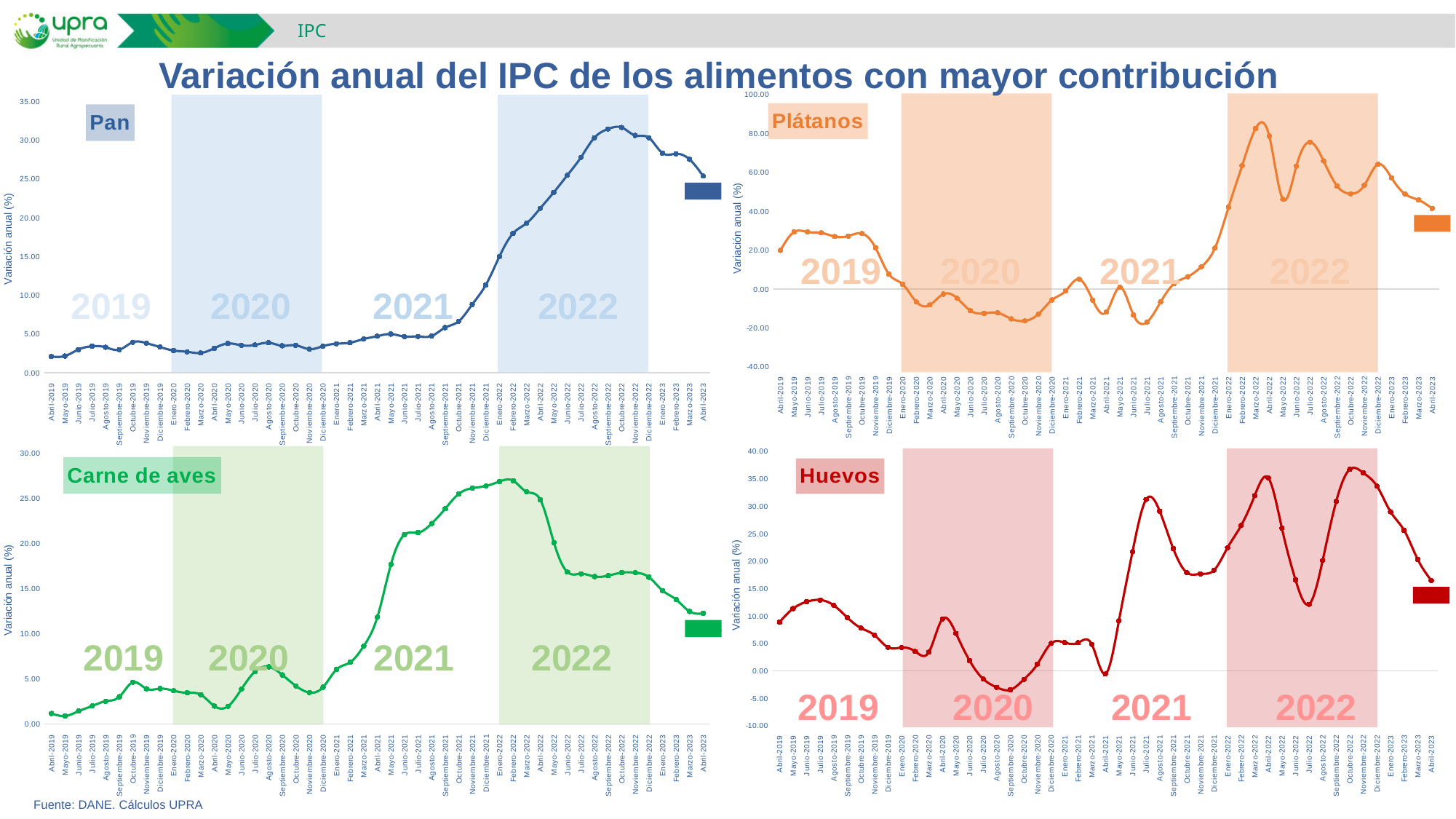
In the 'Carne de aves' chart, is the value for Febrero-2022 greater or less than 25? greater In the 'Pan' chart, is the value for Octubre-2022 greater or less than 30? greater In the 'Plátanos' chart, is the value for Septiembre-2020 greater or less than 0? less In the 'Pan' chart, which is larger, the value for Abril-2019 or the value for Abril-2023? Abril-2023 What source is cited for the charts? Fuente: DANE. Cálculos UPRA In the 'Carne de aves' chart, do the values rise or fall from Febrero-2022 to Abril-2023? fall What kind of chart is the 'Pan' chart? line chart How many charts are shown on the slide? 4 What is the title of the slide's set of charts? Variación anual del IPC de los alimentos con mayor contribución